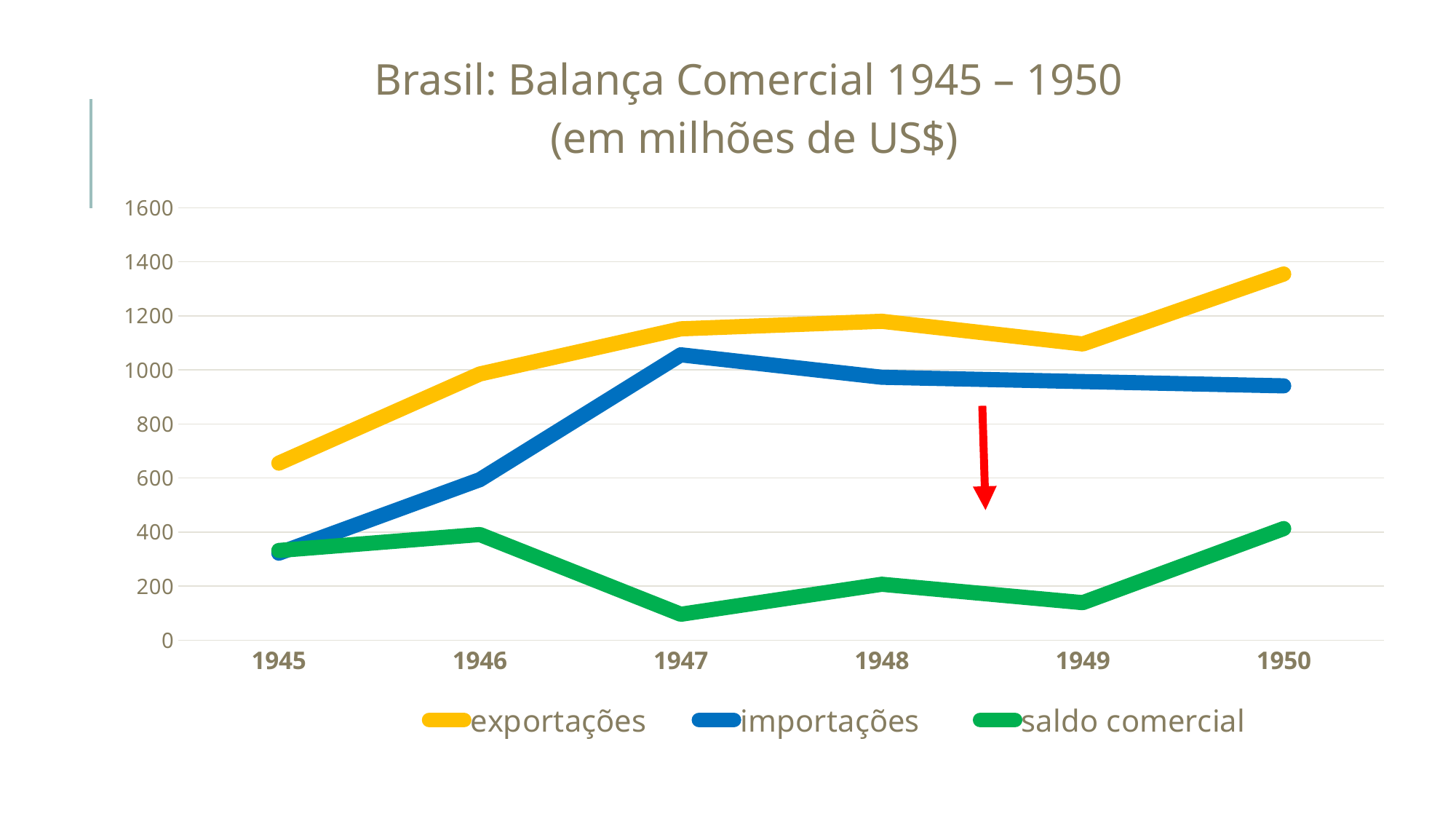
What is the title of the chart? Brasil: Balança Comercial 1945 – 1950 (em milhões de US$) In which year is the saldo comercial lowest? 1947 How many years are plotted along the x axis? 6 What kind of chart is shown on the slide? line chart In which year are importações highest? 1947 Do importações rise or fall from 1947 to 1950? fall Is the value for importações in 1945 greater or less than 400? less How many series does the legend list? 3 In 1947, which is larger: exportações or importações? exportações In which year are exportações highest? 1950 Is the value for exportações in 1950 greater or less than 1200? greater In which year are exportações lowest? 1945